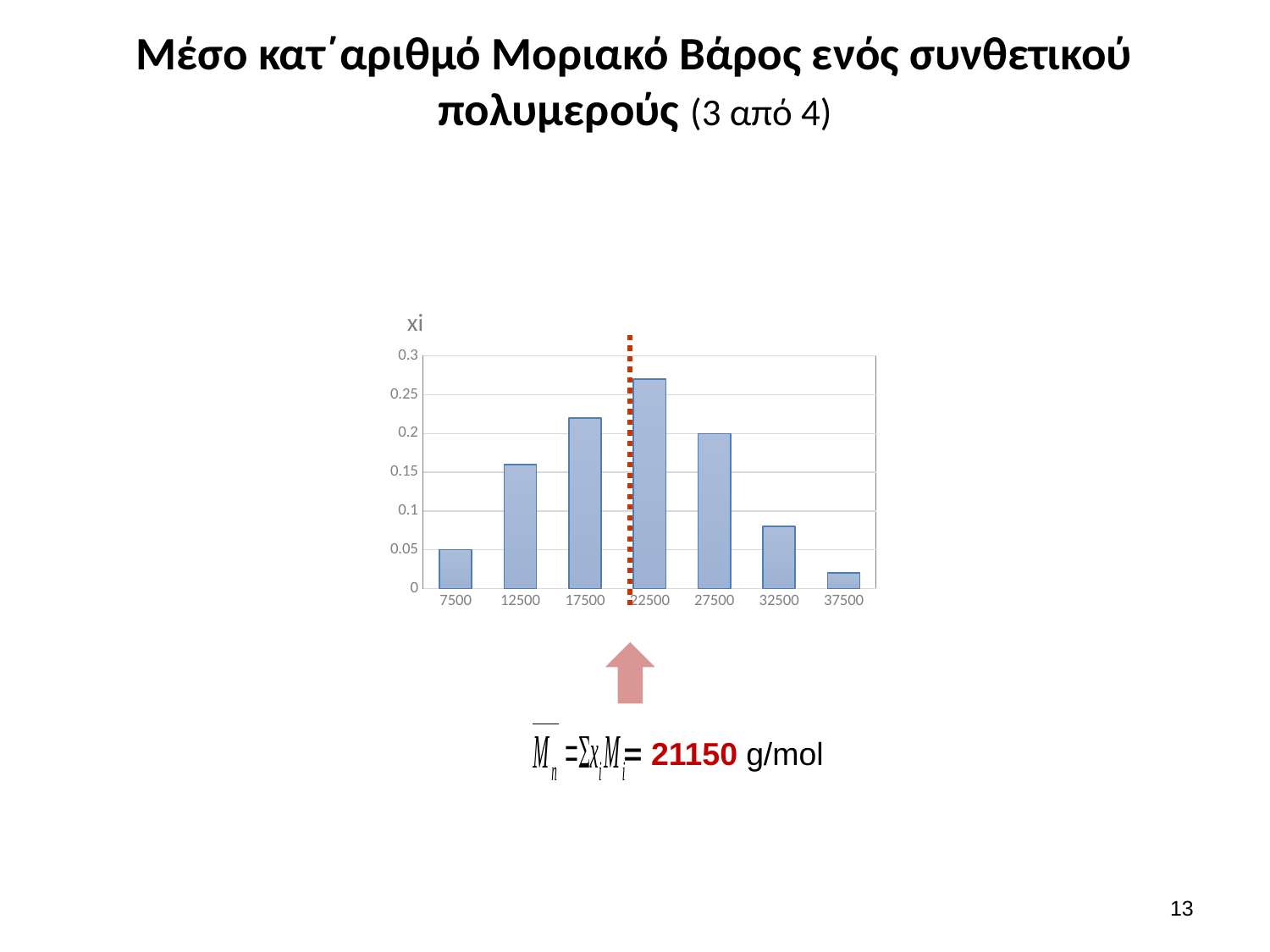
Is the value for 32500 greater or less than 0.1? less Which category has the highest bar in the chart? 22500 Do the values rise or fall from 22500 to 37500 along the x axis? fall Is the value for 12500 greater or less than 0.15? greater Is the value for 17500 greater or less than 0.2? greater Which category has the lowest bar in the chart? 37500 How many bars (categories) are plotted in the chart? 7 What is the value for the 7500 category? 0.05 What kind of chart is shown on the slide? bar chart What label is shown on the vertical axis of the chart? xi Which has the larger value, 17500 or 27500? 17500